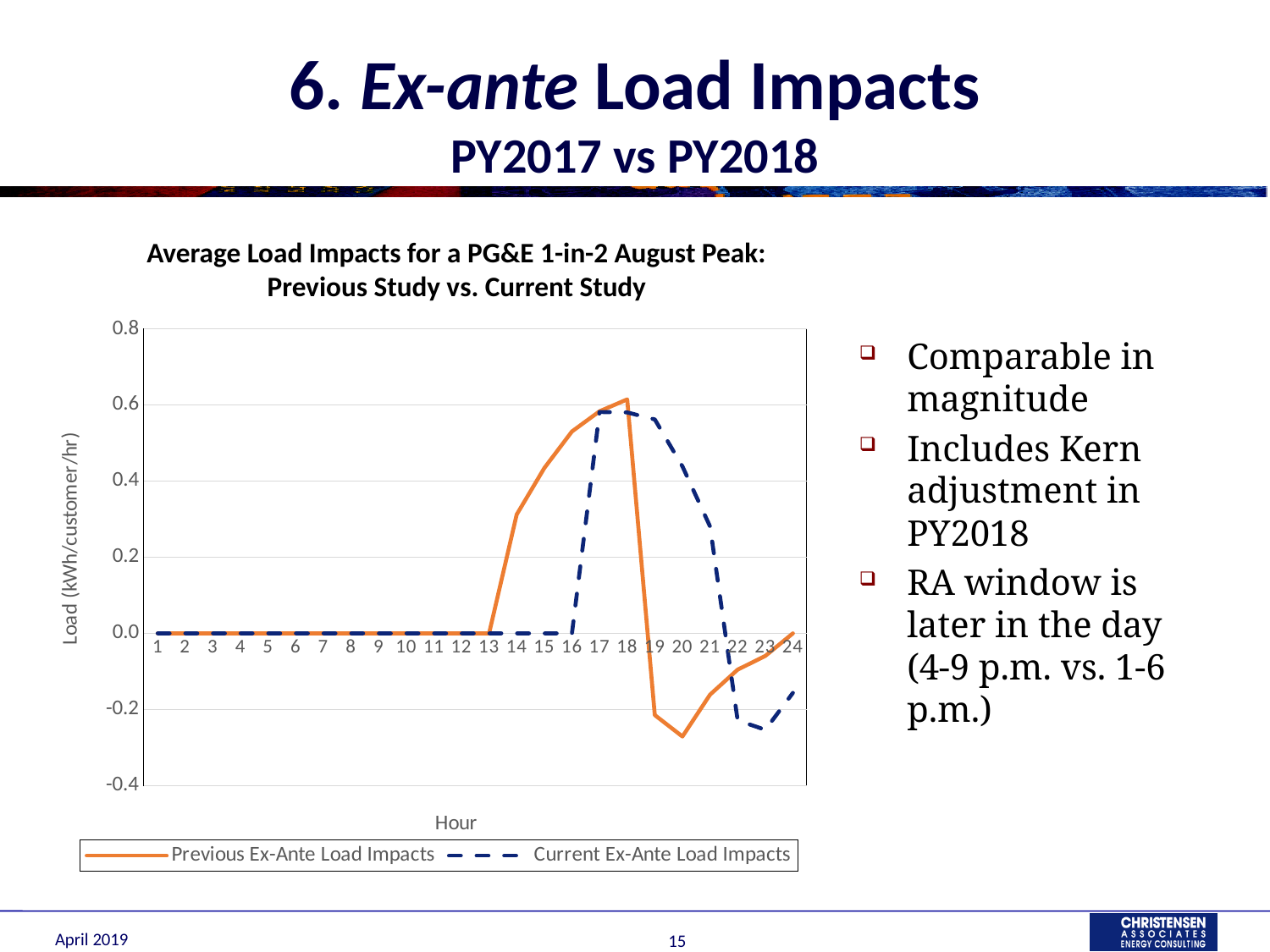
What is the value of Current Ex-Ante Load Impacts at hour 15? 0.0 Is the value of Previous Ex-Ante Load Impacts at hour 20 greater or less than -0.2? less Is the value of Previous Ex-Ante Load Impacts at hour 18 greater or less than 0.4? greater At which hour does Previous Ex-Ante Load Impacts reach its highest value? 18 What is the value of Previous Ex-Ante Load Impacts at hour 5? 0.0 What kind of chart is shown on the slide? line chart How many series does the chart legend list? 2 What is the label of the y axis of the chart? Load (kWh/customer/hr) At which hour does Previous Ex-Ante Load Impacts reach its lowest value? 20 How many hours are plotted along the x axis of the chart? 24 At hour 14, which series has the larger value, Previous Ex-Ante Load Impacts or Current Ex-Ante Load Impacts? Previous Ex-Ante Load Impacts Is the value of Current Ex-Ante Load Impacts at hour 22 greater or less than 0.0? less